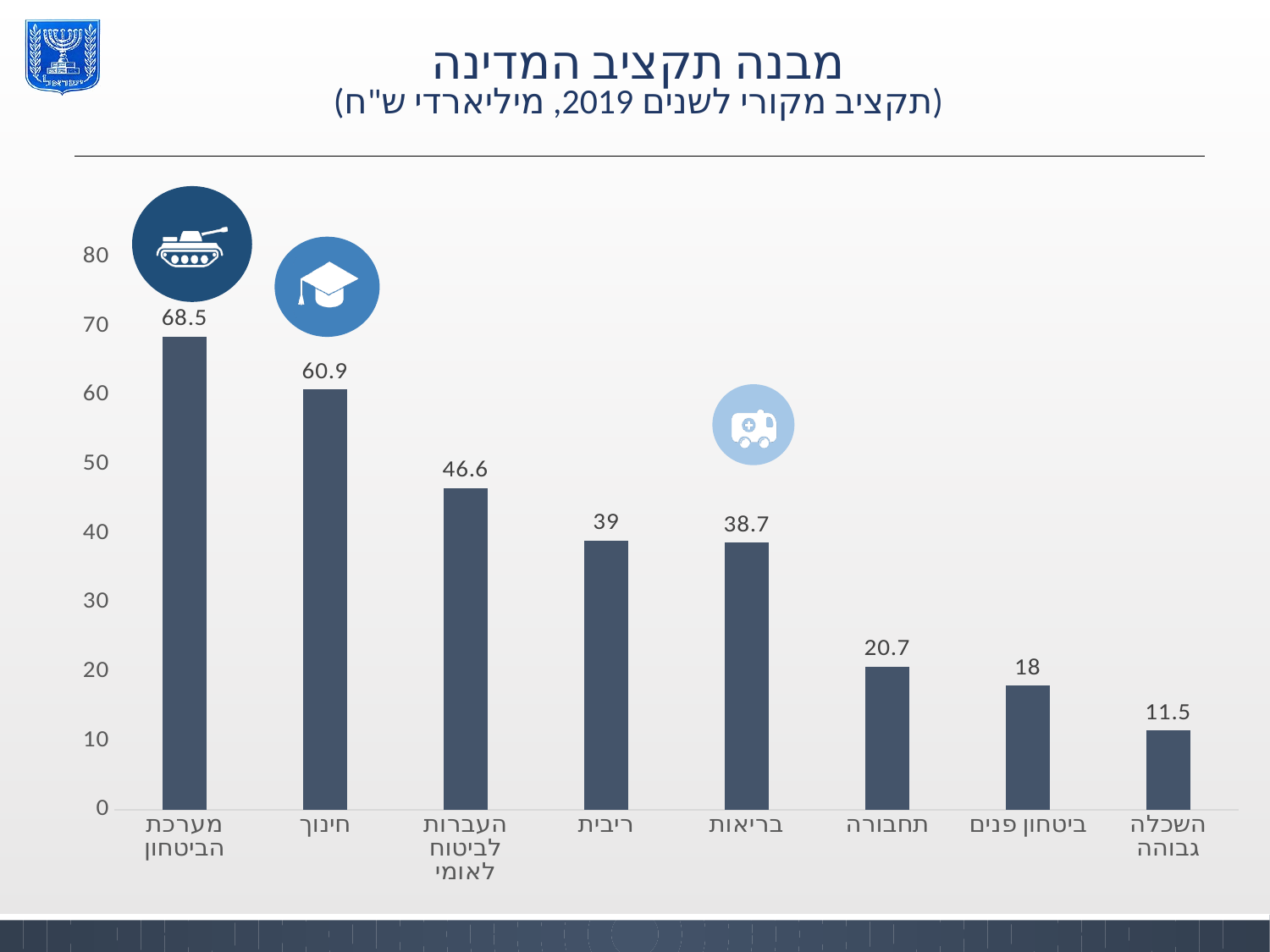
Do the values rise or fall from left to right along the x axis? fall What is the value for העברות לביטוח לאומי? 46.6 What is the value for מערכת הביטחון? 68.5 What is the difference between the values for ביטחון פנים and השכלה גבוהה? 6.5 Which is larger, the value for ריבית or the value for תחבורה? ריבית What is the value for תחבורה? 20.7 What kind of chart is shown on the slide? bar chart What is the difference between the values for מערכת הביטחון and חינוך? 7.6 How many categories are shown in the chart? 8 What is the value for חינוך? 60.9 Which category has the lowest value? השכלה גבוהה Which category has the highest value? מערכת הביטחון